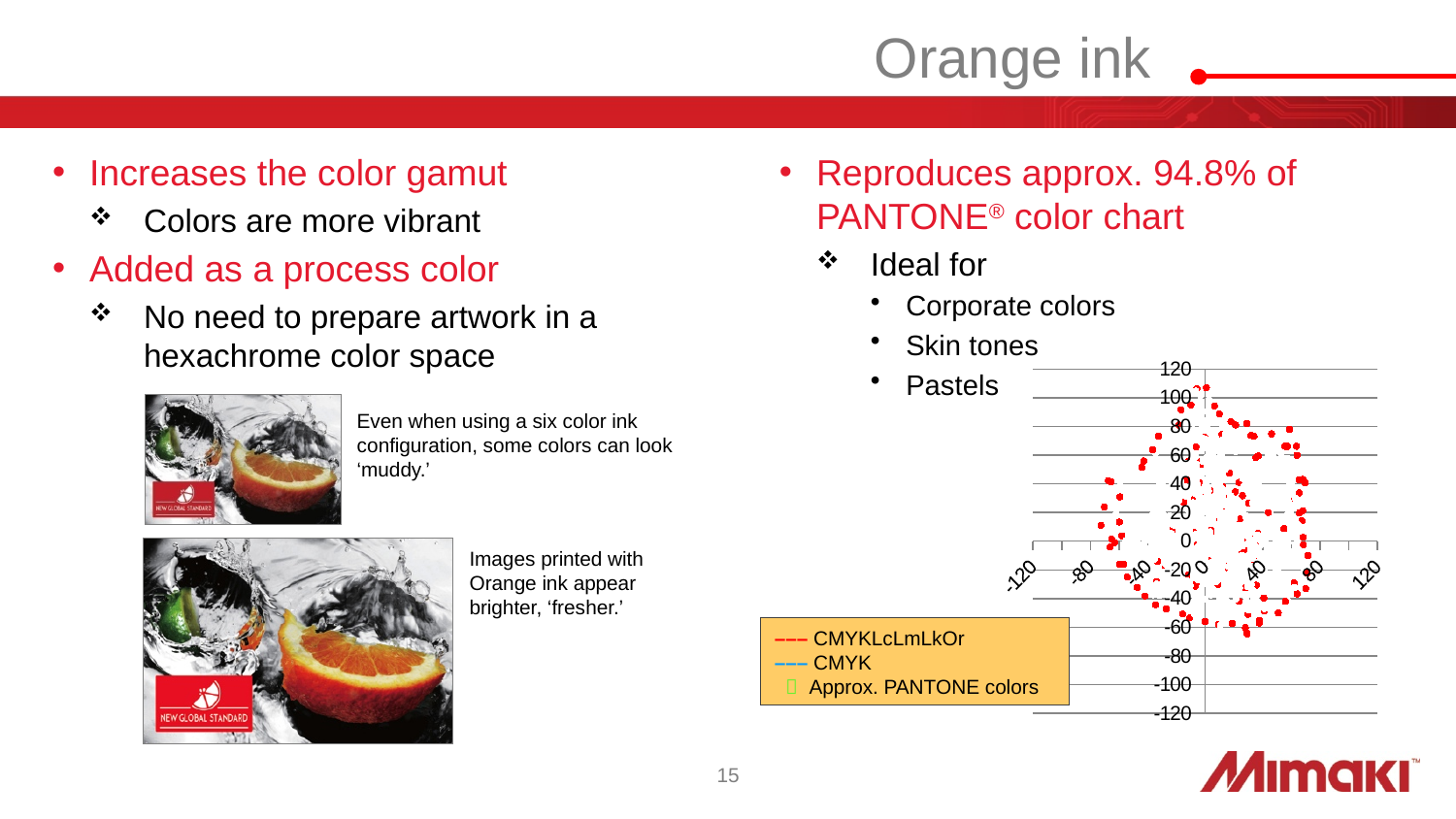
How many series does the legend of the chart list? 3 What is the first entry listed in the chart's legend? CMYKLcLmLkOr What is the maximum value shown on the chart's vertical axis? 120 Is the lowest plotted point on the chart greater or less than -80 on the vertical axis? greater Is the topmost plotted point on the chart greater or less than 80 on the vertical axis? greater What kind of chart is shown on the right side of the slide? scatter chart